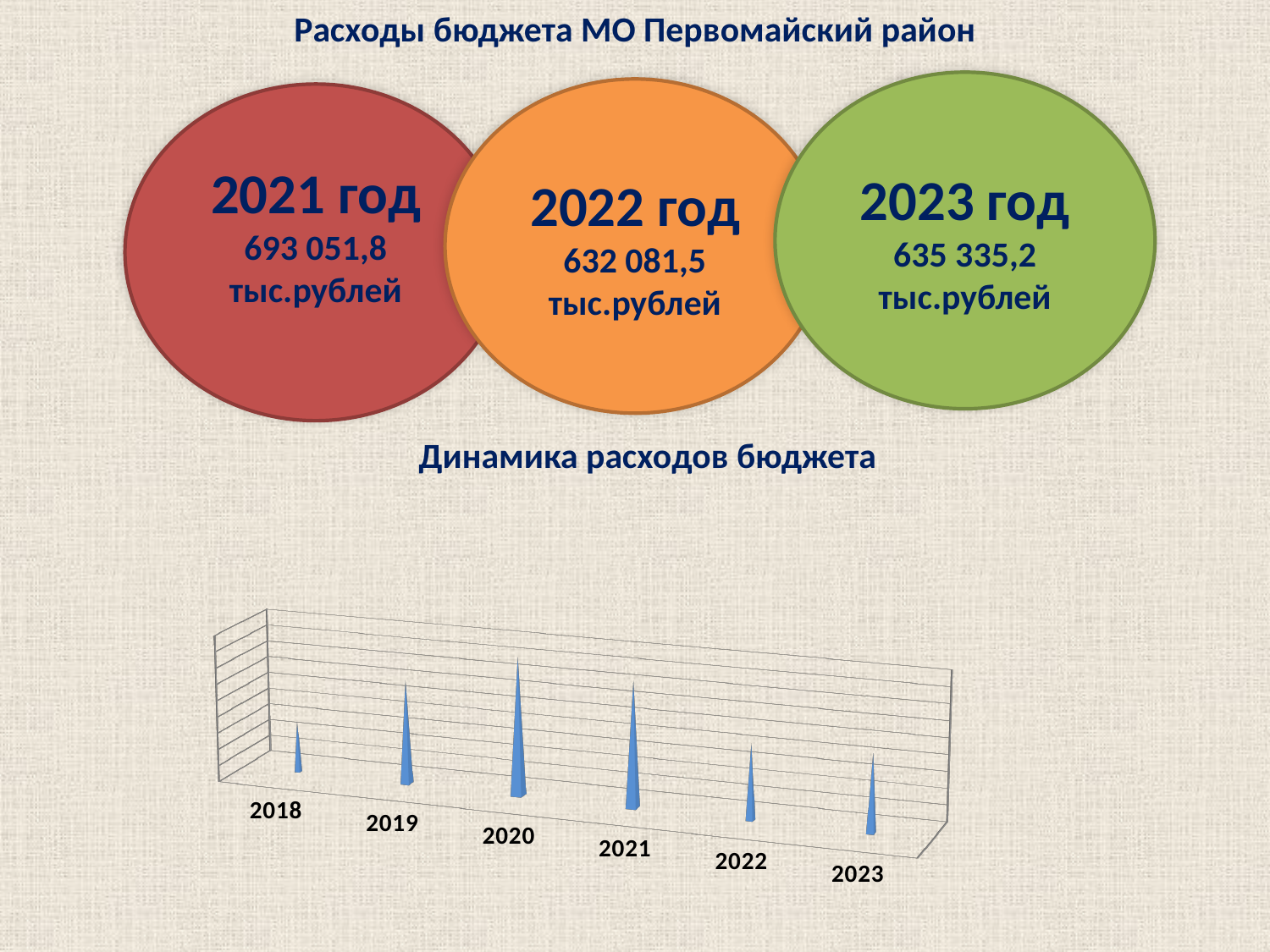
What is the title of the chart at the bottom of the slide? Динамика расходов бюджета What kind of chart is shown under the heading "Динамика расходов бюджета"? bar chart Which year has the lowest value on the "Динамика расходов бюджета" chart? 2018 Which year has the highest value on the "Динамика расходов бюджета" chart? 2020 What is the first year shown on the x axis of the "Динамика расходов бюджета" chart? 2018 On the "Динамика расходов бюджета" chart, do the values rise or fall from 2018 to 2020? rise On the "Динамика расходов бюджета" chart, which is larger, the value for 2020 or the value for 2021? 2020 On the "Динамика расходов бюджета" chart, which is larger, the value for 2021 or the value for 2019? 2021 On the "Динамика расходов бюджета" chart, do the values rise or fall from 2020 to 2022? fall How many years are plotted on the "Динамика расходов бюджета" chart? 6 On the "Динамика расходов бюджета" chart, which is larger, the value for 2019 or the value for 2022? 2019